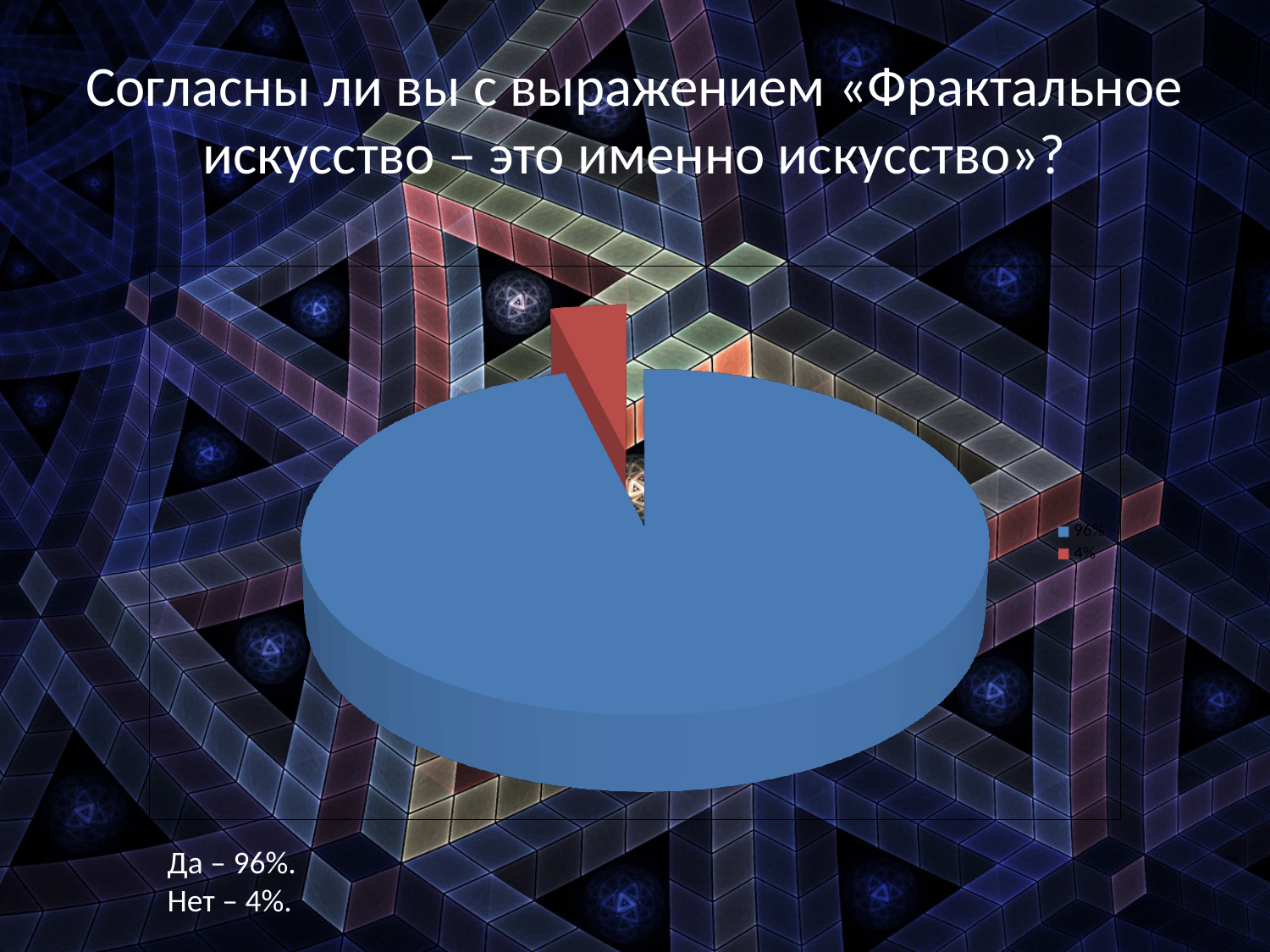
What share of the pie does the blue slice represent? 96% What kind of chart is shown on the slide? pie chart Which slice is larger, the blue one or the red one? the blue one What share of the pie does the red slice represent? 4% Which answer has the smallest share of the pie? Нет What is the difference in percentage points between the "Да" and "Нет" shares? 92 Which answer has the largest share of the pie, "Да" or "Нет"? Да How many entries does the legend of the pie chart list? 2 According to the slide, what percentage answered "Да"? 96% According to the slide, what percentage answered "Нет"? 4% What colour is the slice representing 4%? red How many slices does the pie chart have? 2